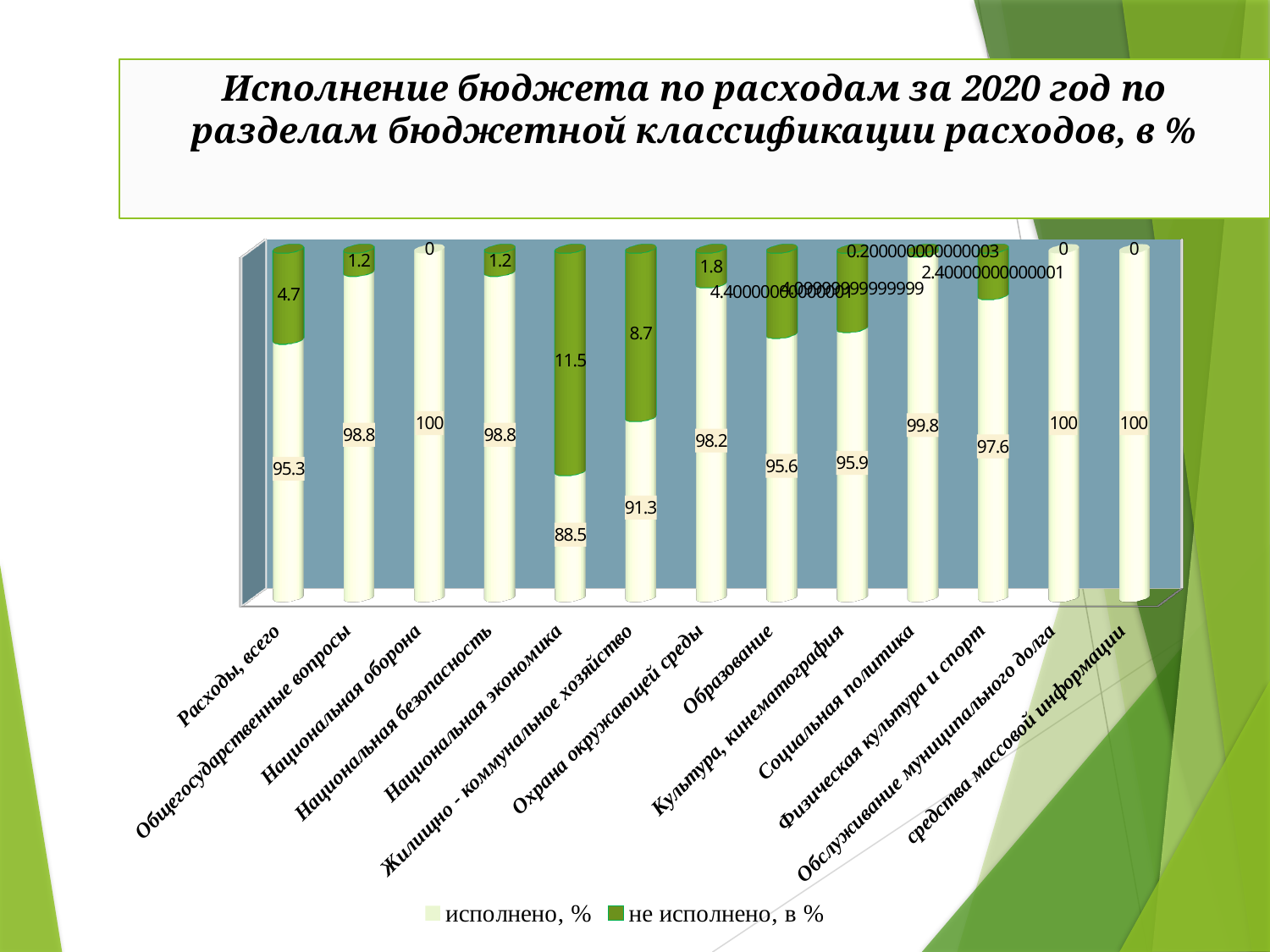
What is the value of "исполнено, %" for Расходы, всего? 95.3 What is the value of "не исполнено, в %" for Жилищно - коммунальное хозяйство? 8.7 Which category has the lowest value of "исполнено, %"? Национальная экономика What is the value of "не исполнено, в %" for Охрана окружающей среды? 1.8 What is the value of "исполнено, %" for Национальная экономика? 88.5 Which has a larger "исполнено, %" value: Социальная политика or Физическая культура и спорт? Социальная политика Which category has the highest value of "не исполнено, в %"? Национальная экономика What kind of chart is shown on the slide? Stacked bar chart How many series does the legend list? 2 What is the difference between the "исполнено, %" values for Общегосударственные вопросы and Жилищно - коммунальное хозяйство? 7.5 How many categories are shown on the x axis? 13 What is the total of the stacked bar for Национальная безопасность? 100